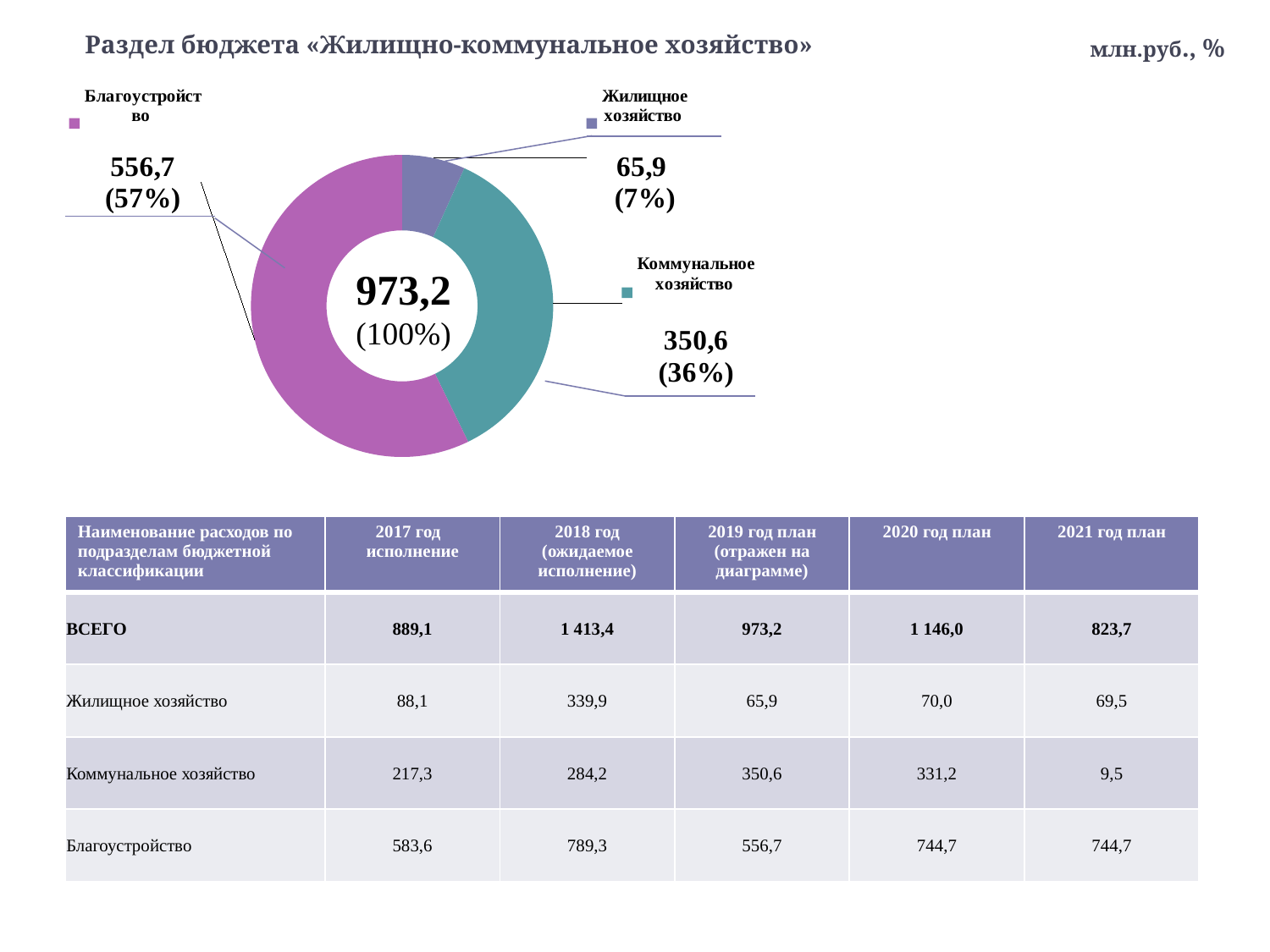
What share of the chart does Благоустройство represent? 57% What kind of chart is shown on the slide? Donut (pie) chart What is the value shown for Жилищное хозяйство in the chart? 65,9 How many categories are shown in the chart? 3 Which category has the largest slice in the chart? Благоустройство What total value is shown in the centre of the chart? 973,2 What share of the chart does Коммунальное хозяйство represent? 36% What is the value shown for Коммунальное хозяйство in the chart? 350,6 What is the difference between the values for Благоустройство and Коммунальное хозяйство in the chart? 206,1 Which category has the smallest slice in the chart? Жилищное хозяйство What is the value shown for Благоустройство in the chart? 556,7 What share of the chart does Жилищное хозяйство represent? 7%